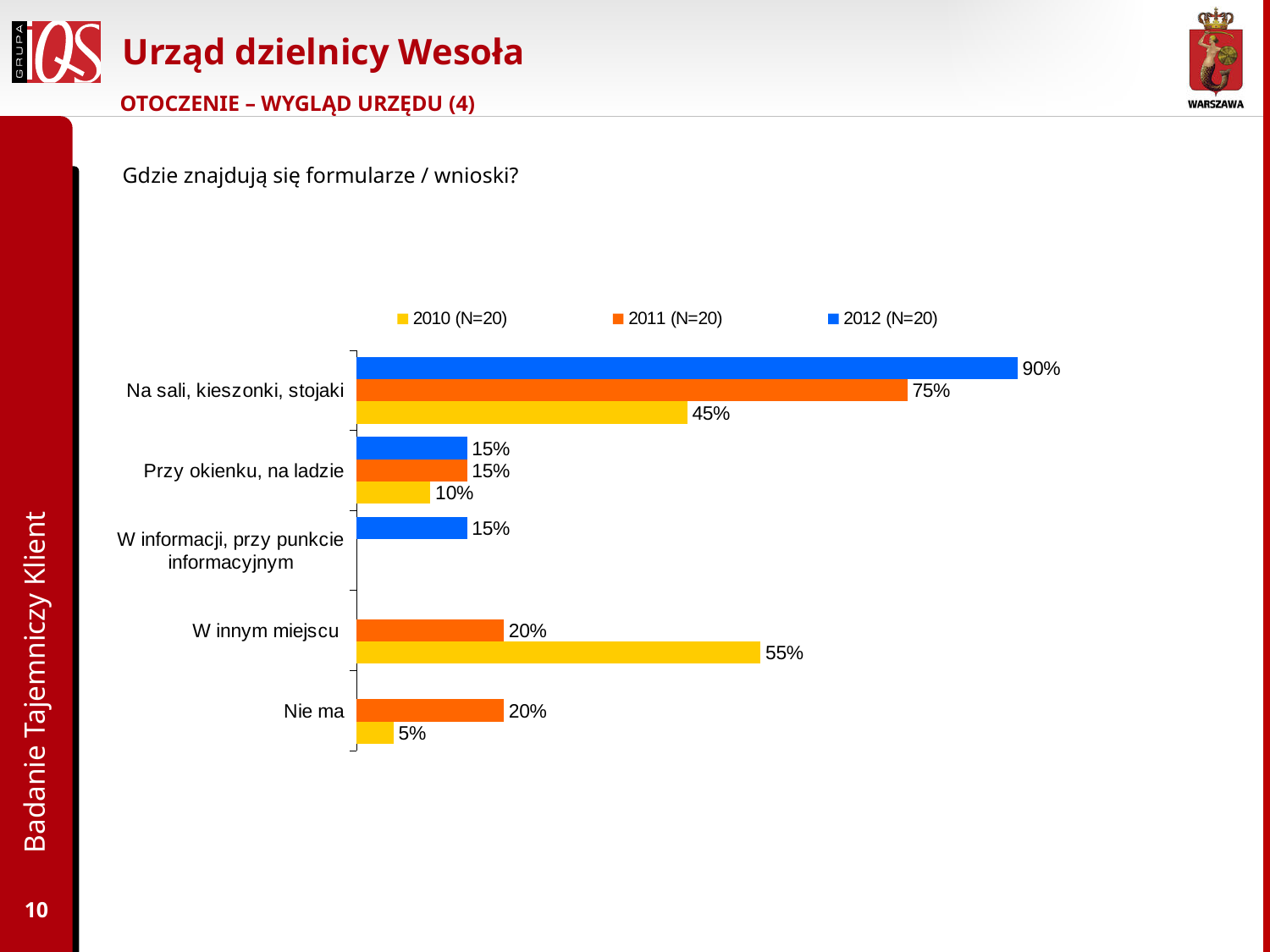
How many series does the legend list? 3 How many categories are shown on the chart? 5 What is the value for 'W innym miejscu' in the 2010 (N=20) series? 55% What is the difference between the 2012 (N=20) and 2010 (N=20) values for 'Na sali, kieszonki, stojaki'? 45% What is the value for 'Na sali, kieszonki, stojaki' in the 2012 (N=20) series? 90% Which category has the lowest value in the 2010 (N=20) series? Nie ma Which category has the highest value in the 2012 (N=20) series? Na sali, kieszonki, stojaki What is the value for 'Przy okienku, na ladzie' in the 2010 (N=20) series? 10% What question is the chart answering, as stated above it? Gdzie znajdują się formularze / wnioski? What is the value for 'Nie ma' in the 2011 (N=20) series? 20% What kind of chart is shown on the slide? Bar chart Which is larger for 'W innym miejscu': the 2010 (N=20) value or the 2011 (N=20) value? 2010 (N=20)